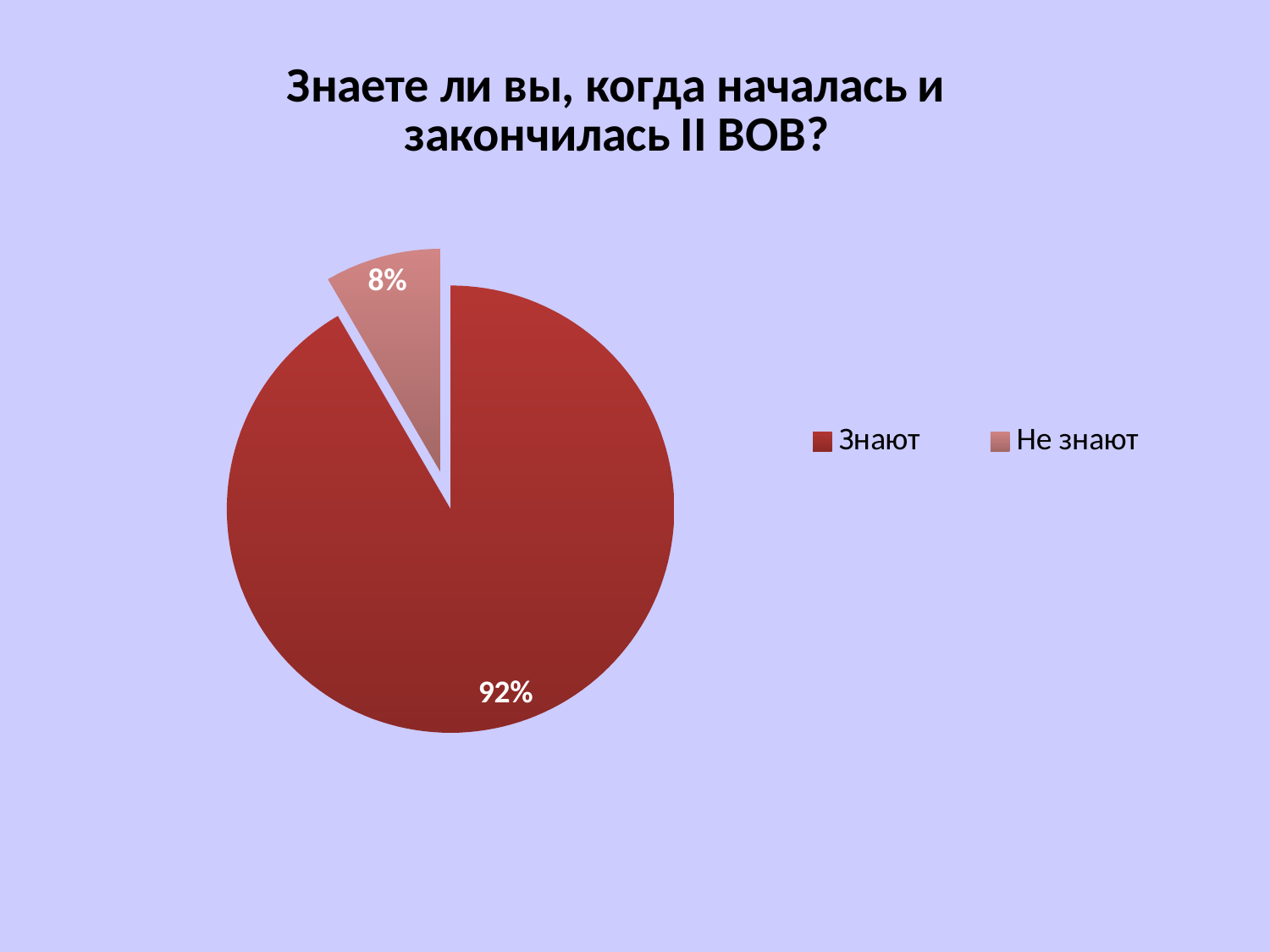
What is the difference in percentage points between "Знают" and "Не знают"? 84 Which is larger, the share for "Знают" or for "Не знают"? Знают What percentage of the pie is labelled "Не знают"? 8% What kind of chart is shown on the slide? Pie chart How many slices does the pie chart have? 2 What is the title of the chart? Знаете ли вы, когда началась и закончилась II ВОВ? What percentage of the pie is labelled "Знают"? 92% How many entries does the legend list? 2 Which slice is pulled out (exploded) from the pie? Не знают Which category has the smallest share of the pie? Не знают Which category has the largest share of the pie? Знают